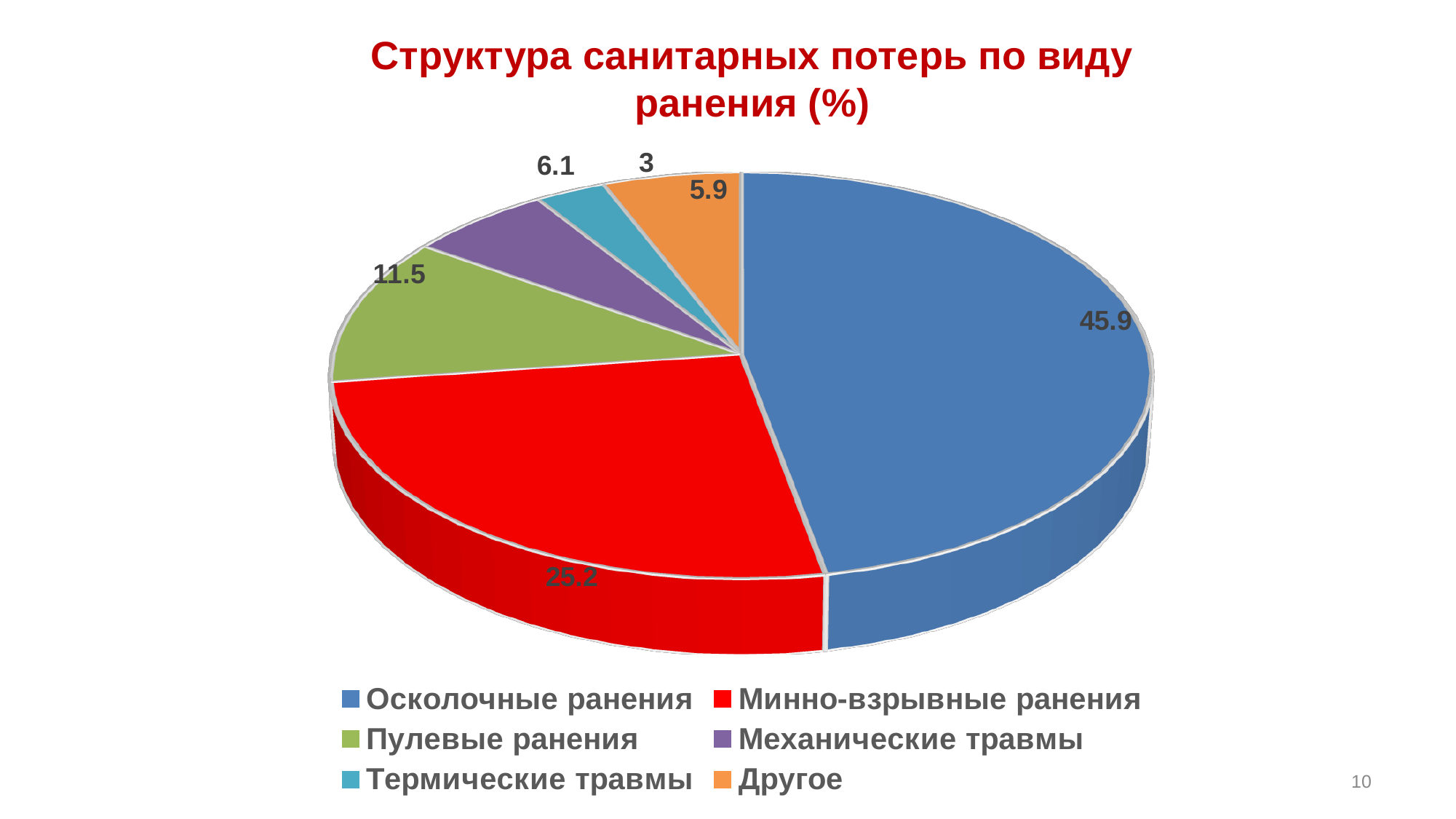
What type of chart is shown on the slide? pie chart What is the value for Термические травмы? 3 What is the title of the chart? Структура санитарных потерь по виду ранения (%) What is the value for Осколочные ранения? 45.9 What is the difference between the values for Осколочные ранения and Минно-взрывные ранения? 20.7 Which category has the smallest share of the pie? Термические травмы What is the value for Другое? 5.9 How many categories does the pie chart have? 6 Which category has the largest share of the pie? Осколочные ранения What is the value for Механические травмы? 6.1 What is the value for Минно-взрывные ранения? 25.2 What is the value for Пулевые ранения? 11.5